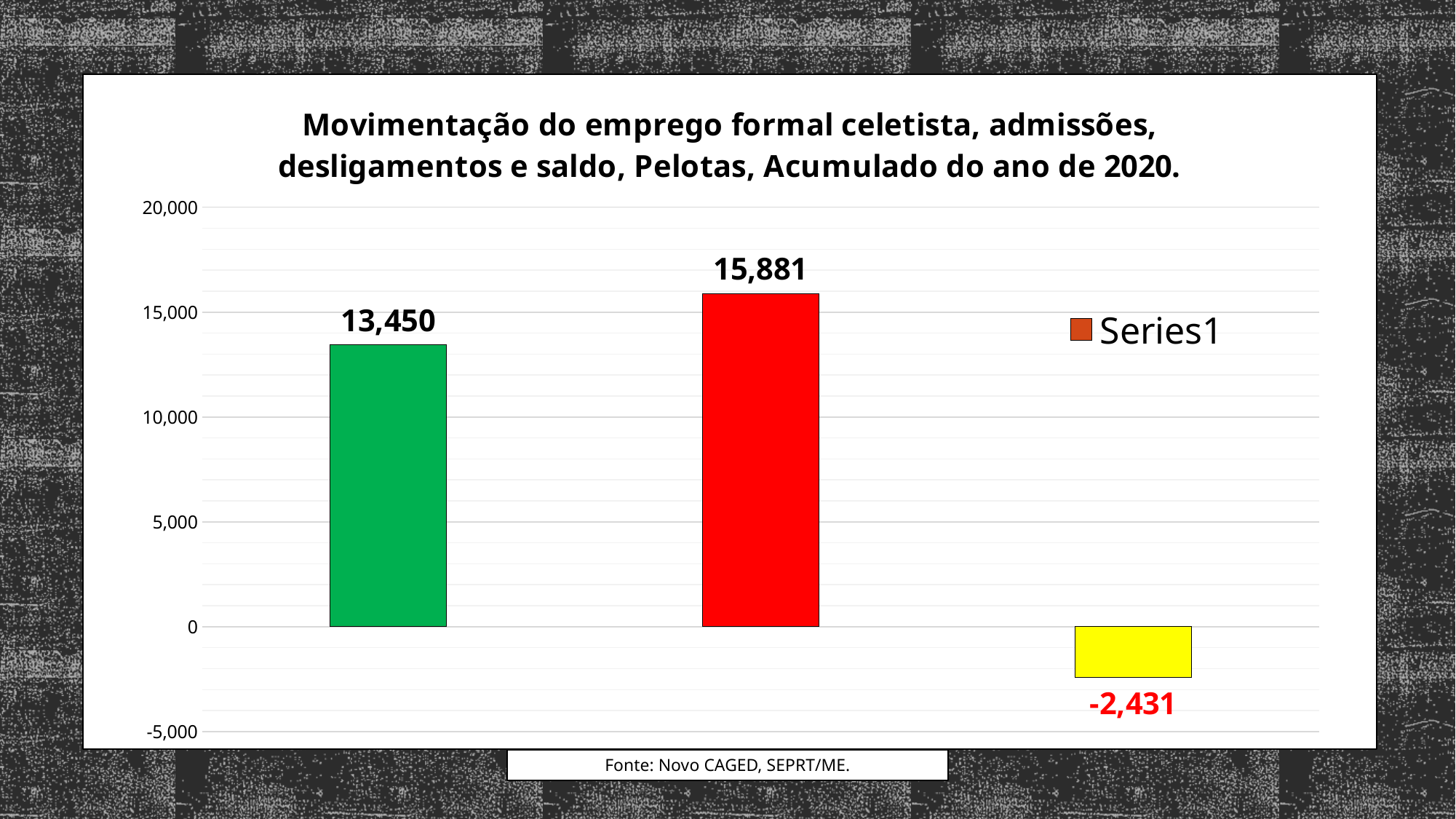
How many bars are plotted in the chart? 3 Which is larger, the value of the green bar or the value of the red bar? the red bar Which bar has the highest value? the red bar (15,881) Is the value of the green bar greater or less than 15,000? less What is the value shown on the red bar (the middle bar)? 15,881 What is the value shown on the green bar (the leftmost bar)? 13,450 What is the difference between the red bar's value and the green bar's value? 2,431 What type of chart is shown on the slide? bar chart Which bar has the lowest value? the yellow bar (-2,431) How many series does the legend list? 1 What is the value shown on the yellow bar (the rightmost bar)? -2,431 What is the name of the series shown in the legend? Series1